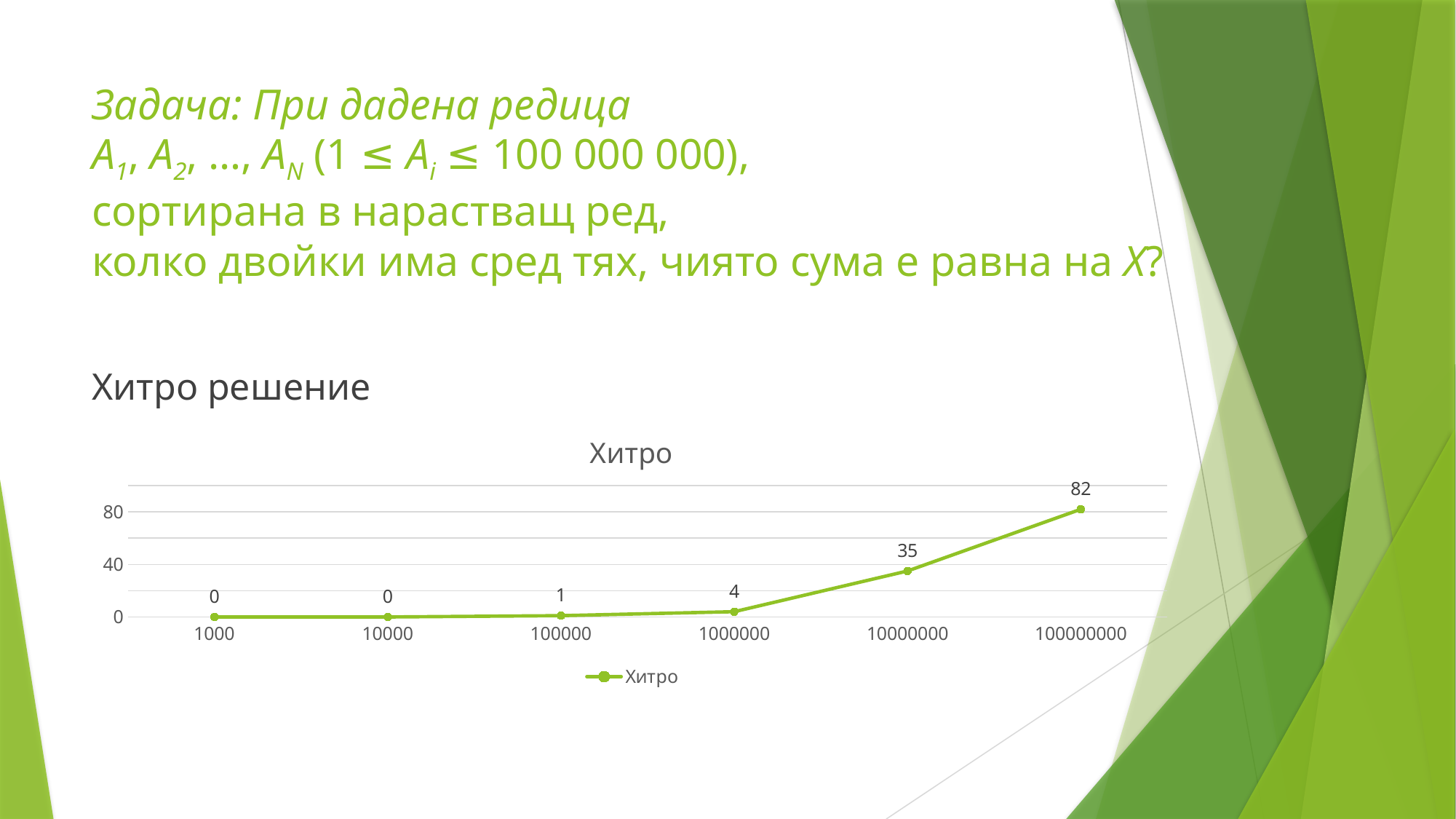
Which category has the highest value? 100000000 Which is larger, the value for 1000000 or the value for 10000000? 10000000 What is the value for 100000000 in the chart? 82 Do the values rise or fall along the x axis? rise How many series does the legend list? 1 What is the value for 100000 in the chart? 1 What is the difference between the values for 100000000 and 10000000? 47 Is the value for 100000000 greater or less than 80? greater What is the value for 1000000 in the chart? 4 What kind of chart is shown on the slide? line chart How many data points are plotted in the chart? 6 What is the value for 10000000 in the chart? 35